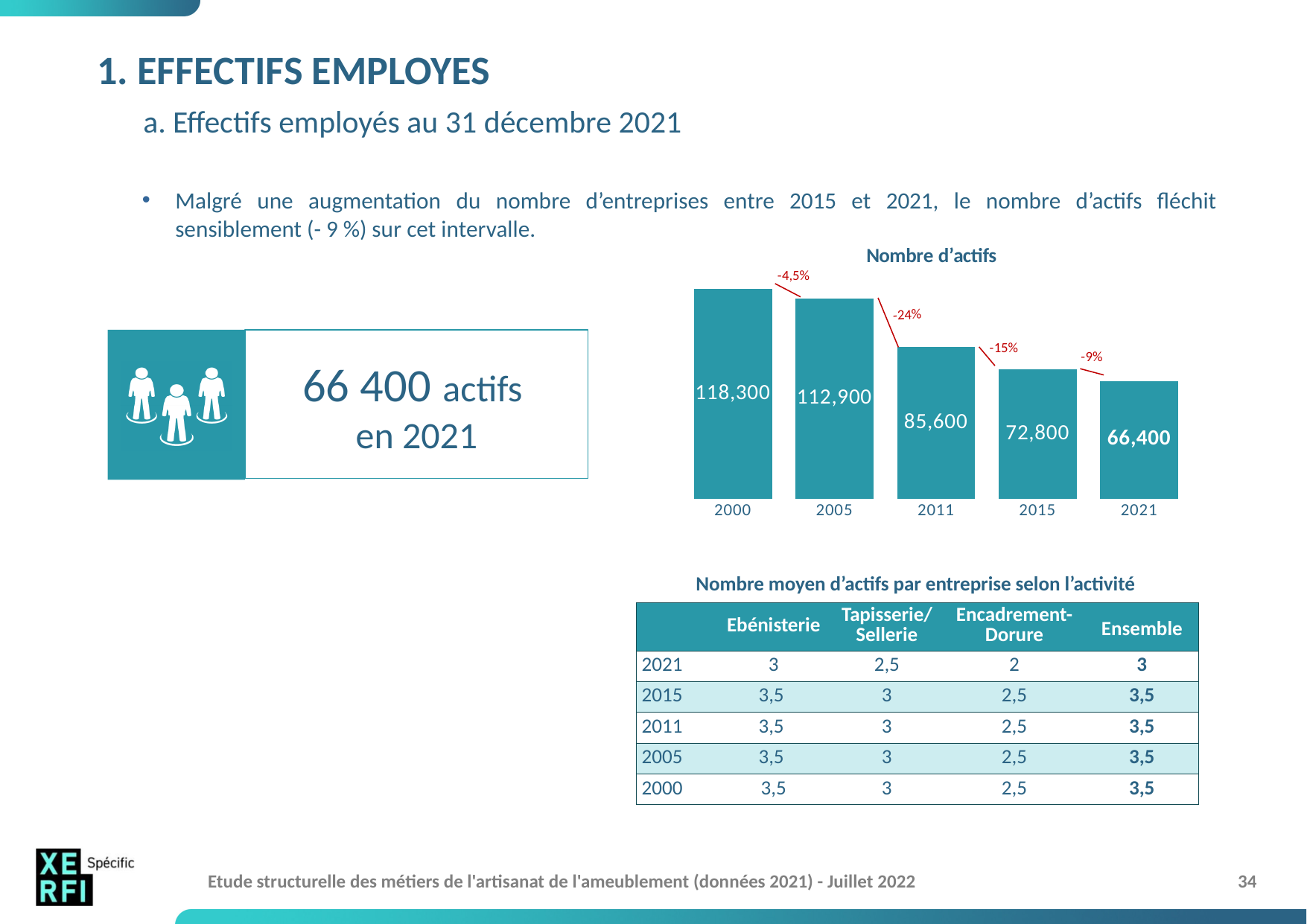
How many bars are shown in the 'Nombre d'actifs' chart? 5 In the 'Nombre d'actifs' chart, what percentage change is annotated between 2005 and 2011? -24% In the 'Nombre d'actifs' chart, what is the value for 2011? 85,600 In the 'Nombre d'actifs' chart, what is the difference between the values for 2000 and 2005? 5,400 In the 'Nombre d'actifs' chart, which year has the lowest value? 2021 In the 'Nombre d'actifs' chart, what is the value for 2021? 66,400 In the 'Nombre d'actifs' chart, what is the difference between the values for 2015 and 2021? 6,400 In the 'Nombre d'actifs' chart, what is the value for 2000? 118,300 In the 'Nombre d'actifs' chart, do the values rise or fall from 2000 to 2021? Fall What kind of chart is the 'Nombre d'actifs' chart? Bar chart In the 'Nombre d'actifs' chart, which year has the highest value? 2000 In the 'Nombre d'actifs' chart, which is larger, the value for 2005 or the value for 2011? 2005